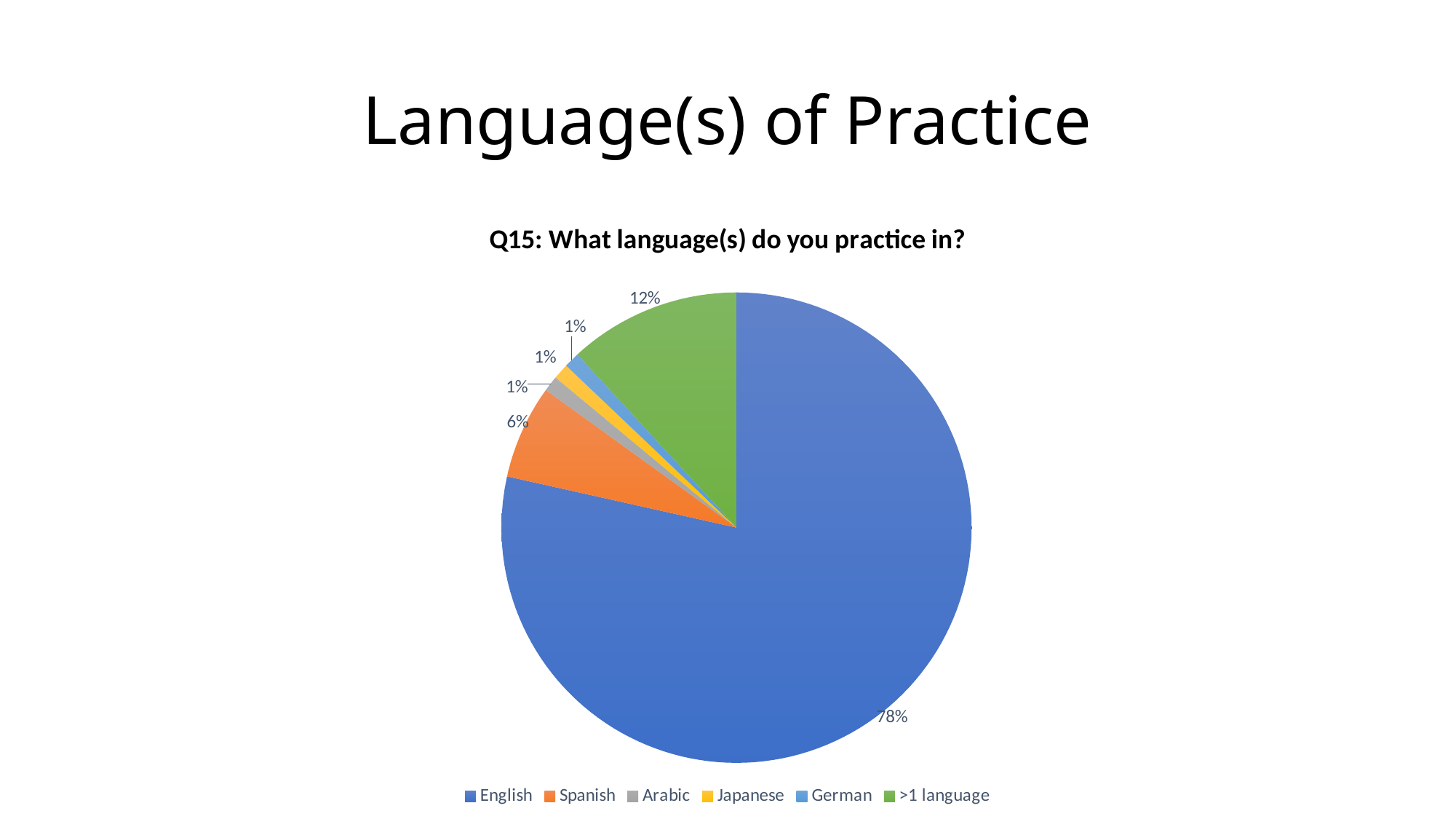
What colour is the slice for Spanish? Orange How many categories does the legend list? 6 What share of the pie does Spanish represent? 6% What share of the pie does >1 language represent? 12% Which is larger, the slice for Spanish or the slice for >1 language? >1 language Which category has the largest slice of the pie? English What kind of chart is shown on the slide? Pie chart What is the difference in percentage points between the >1 language slice and the Spanish slice? 6 What is the title of the chart? Q15: What language(s) do you practice in? What share of the pie does English represent? 78% What is the difference in percentage points between the English slice and the >1 language slice? 66